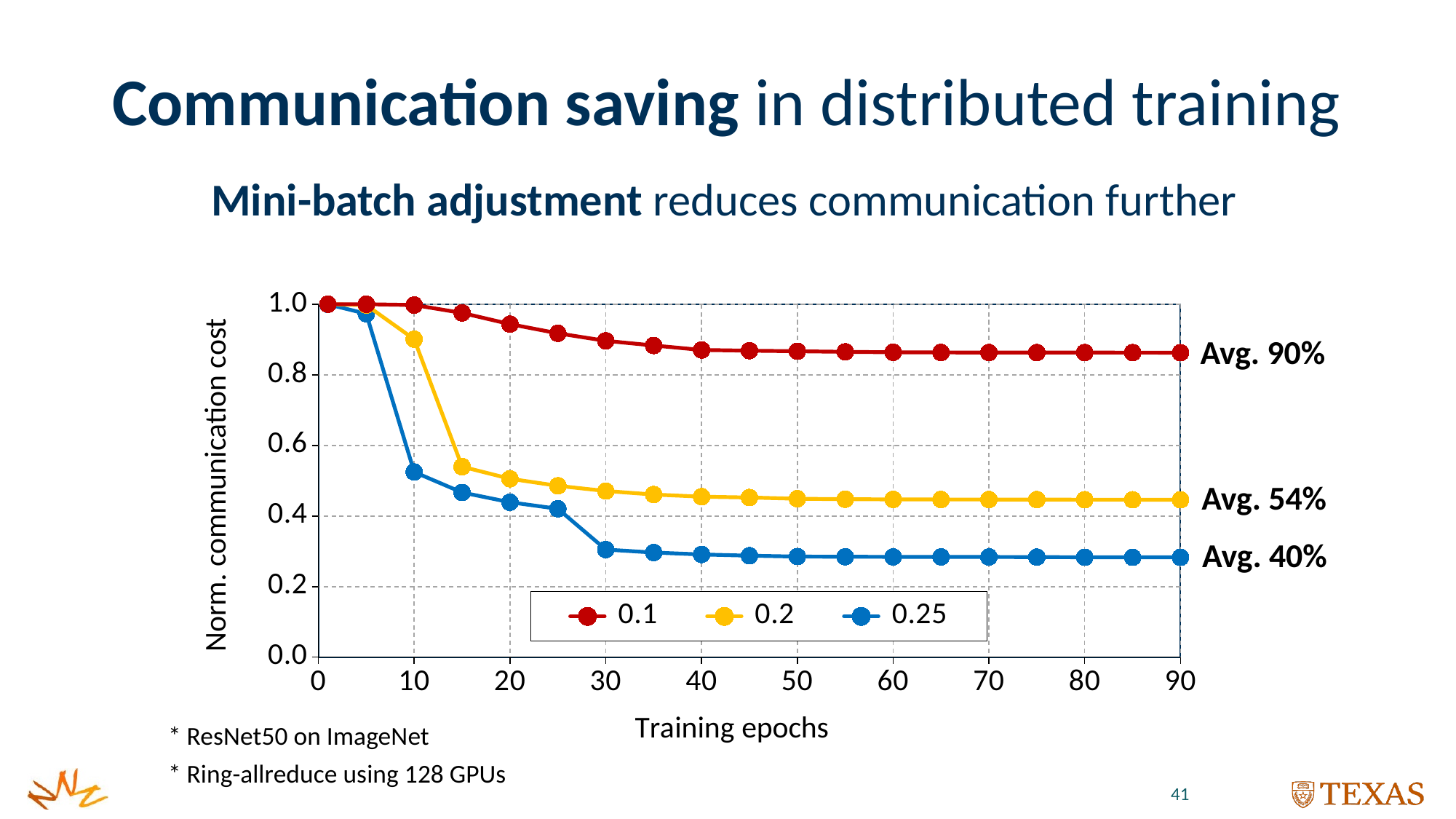
What average communication cost is annotated for the 0.1 series? Avg. 90% What kind of chart is shown on the slide? line chart How many series does the legend list? 3 At epoch 30, which series has the larger normalized communication cost, 0.1 or 0.25? 0.1 Is the value for the 0.25 series at epoch 10 greater or less than 0.6? less Is the value for the 0.1 series at epoch 90 greater or less than 0.8? greater Is the value for the 0.25 series at epoch 90 greater or less than 0.4? less Do the values of the 0.2 series rise or fall as training epochs increase? fall Which series has the highest average normalized communication cost? 0.1 What average communication cost is annotated for the 0.2 series? Avg. 54% What average communication cost is annotated for the 0.25 series? Avg. 40% Which series has the lowest average normalized communication cost? 0.25